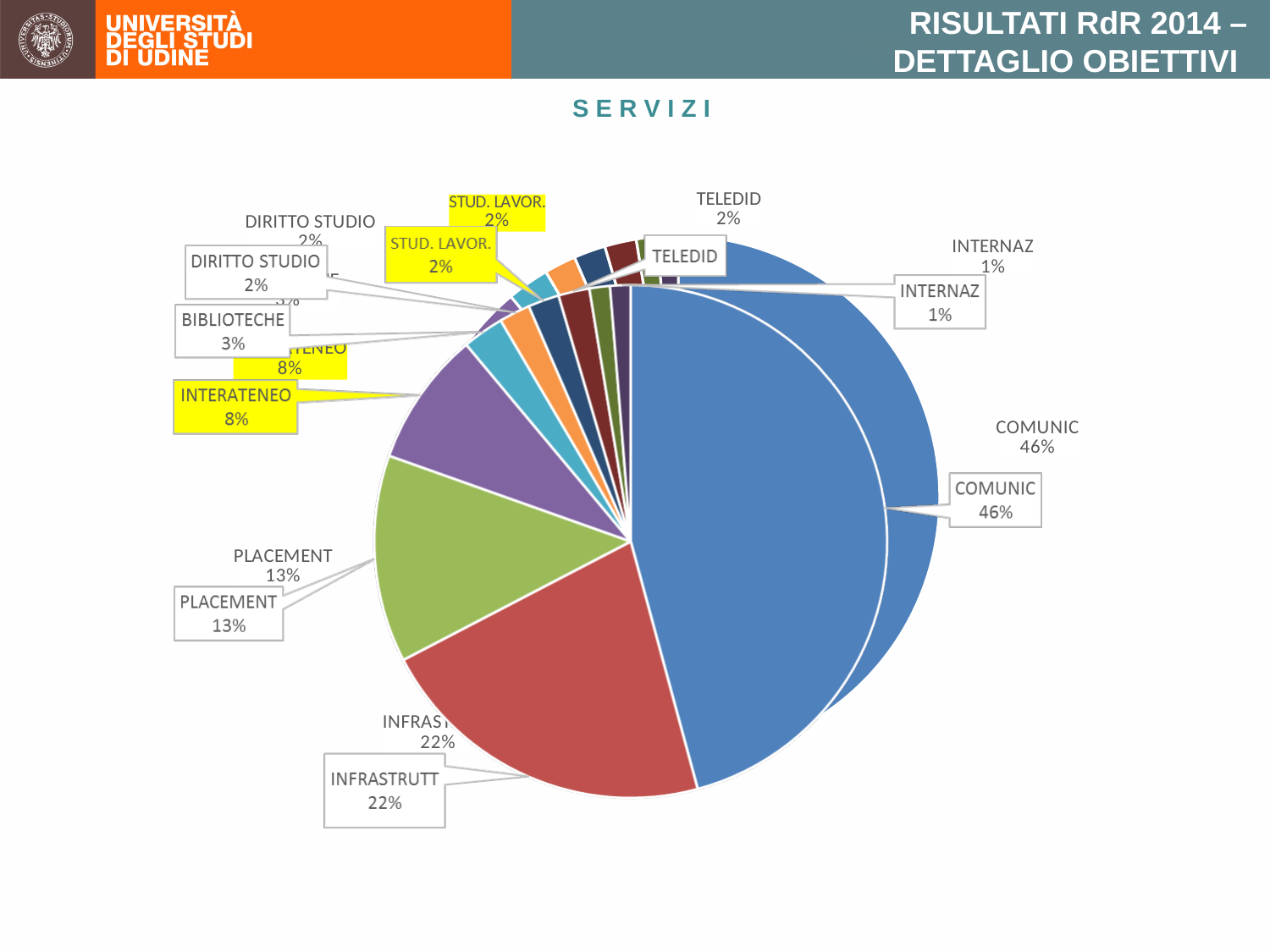
What percentage is shown for INTERATENEO? 8% Which category has the largest share of the pie? COMUNIC What percentage is shown for INTERNAZ? 1% What percentage is shown for PLACEMENT? 13% What is the difference in percentage points between COMUNIC and INFRASTRUTT? 24 What is the title shown above the chart? SERVIZI What percentage is shown for BIBLIOTECHE? 3% What percentage is shown for INFRASTRUTT? 22% What share of the pie does TELEDID represent? 2% What kind of chart is shown on the slide? pie chart Which is larger, PLACEMENT or INTERATENEO? PLACEMENT What percentage is shown for COMUNIC? 46%